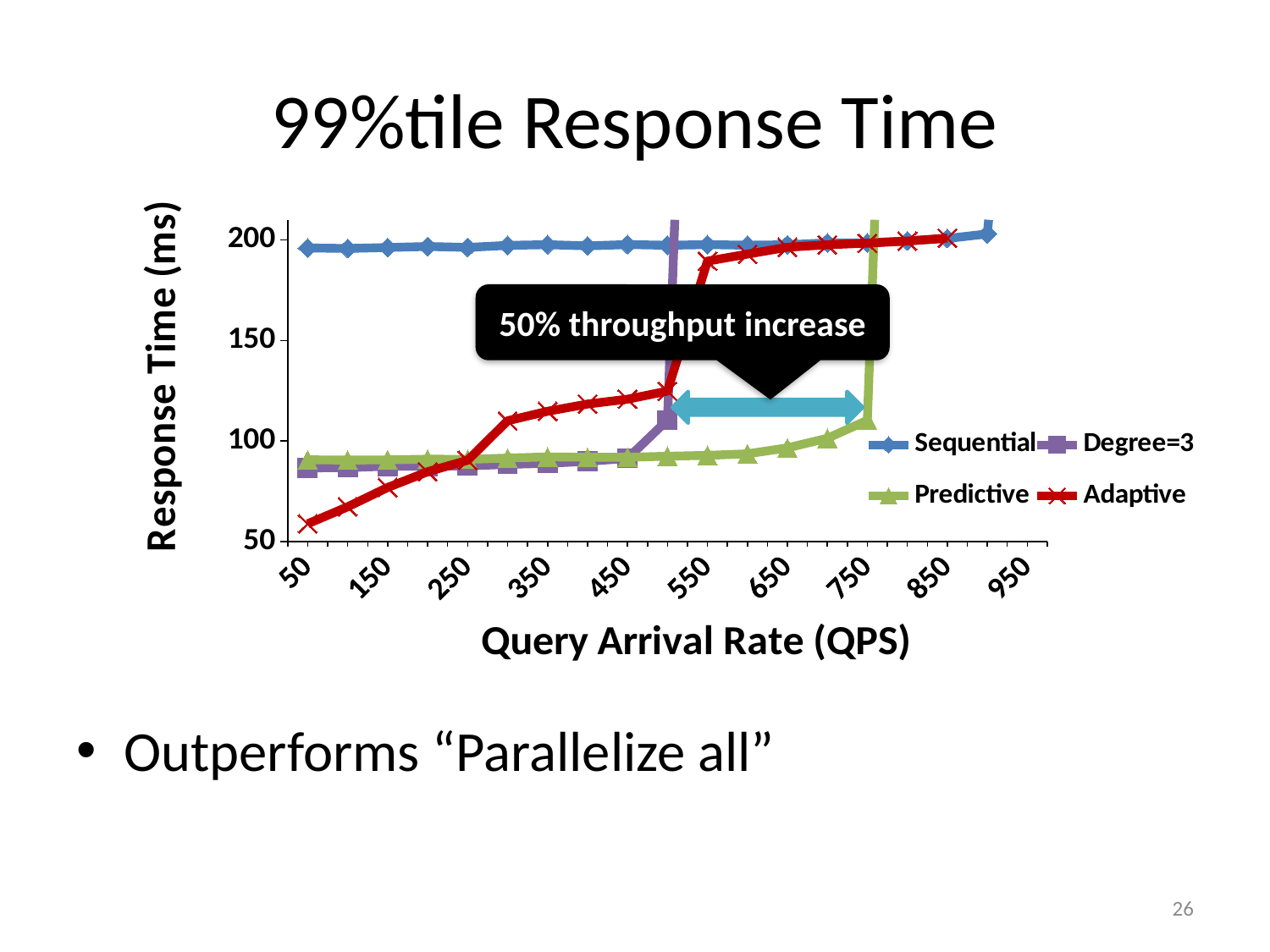
Which series has the highest response time at 50 QPS? Sequential Is the response time for Sequential at 50 QPS greater or less than 150? greater At 350 QPS, which series has the higher response time, Adaptive or Predictive? Adaptive How many series does the legend list? 4 Does the Adaptive series rise or fall as the query arrival rate increases? rises What kind of chart is shown on the slide? line chart Is the response time for Predictive at 450 QPS greater or less than 150? less What text appears in the black callout box on the chart? 50% throughput increase At 50 QPS, which series has the higher response time, Sequential or Adaptive? Sequential Is the response time for Adaptive at 50 QPS greater or less than 100? less What is the title of the x axis? Query Arrival Rate (QPS) Which series has the lowest response time at 50 QPS? Adaptive